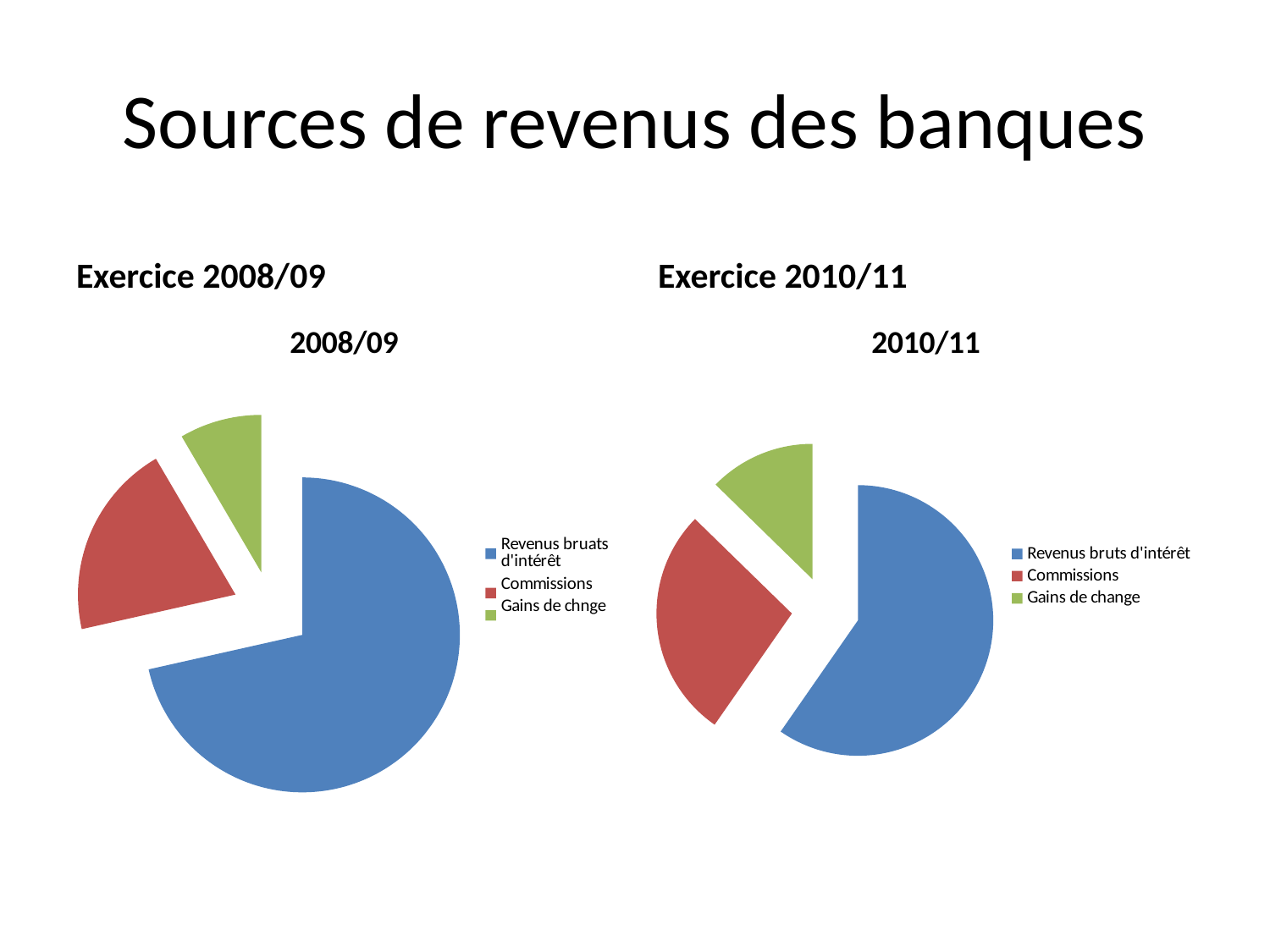
In the 2010/11 chart, how many categories does the legend list? 3 In the 2008/09 chart, which slice is larger: Revenus bruats d'intérêt or Commissions? Revenus bruats d'intérêt In the 2010/11 chart, which category has the largest slice? Revenus bruts d'intérêt What kind of chart is the 2008/09 chart? pie chart In the 2010/11 chart, which category has the smallest slice? Gains de change In the 2010/11 chart, which slice is larger: Commissions or Gains de change? Commissions In the 2008/09 chart, which category has the largest slice? Revenus bruats d'intérêt In the 2008/09 chart, how many slices does the pie have? 3 What kind of chart is the 2010/11 chart? pie chart In the 2010/11 chart, which colour represents Commissions? red What is the title of the chart on the left of the slide? 2008/09 In the 2008/09 chart, which category has the smallest slice? Gains de chnge